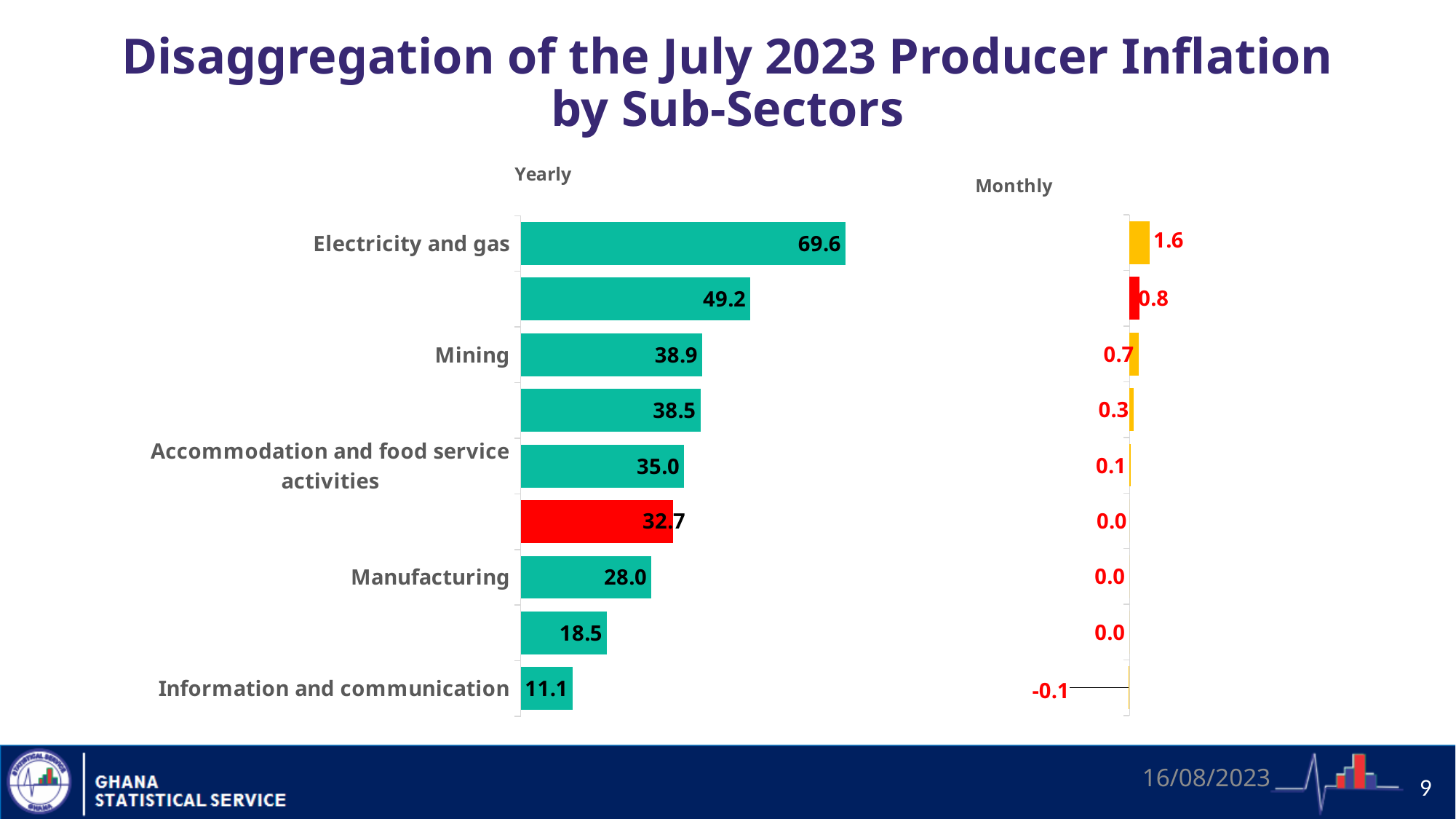
In the Yearly chart, what is the value for Accommodation and food service activities? 35.0 In the Yearly chart, what is the difference between the values for Manufacturing and Information and communication? 16.9 What kind of chart is the Yearly chart? Bar chart In the Yearly chart, what is the difference between the values for Electricity and gas and Mining? 30.7 In the Yearly chart, which labelled sub-sector has the highest value? Electricity and gas How many bars are plotted in the Yearly chart? 9 In the Monthly chart, what is the value for Information and communication? -0.1 In the Yearly chart, which is larger: the value for Mining or the value for Accommodation and food service activities? Mining In the Yearly chart, what is the value for Electricity and gas? 69.6 In the Monthly chart, which labelled sub-sector has the lowest value? Information and communication In the Yearly chart, what is the value for Mining? 38.9